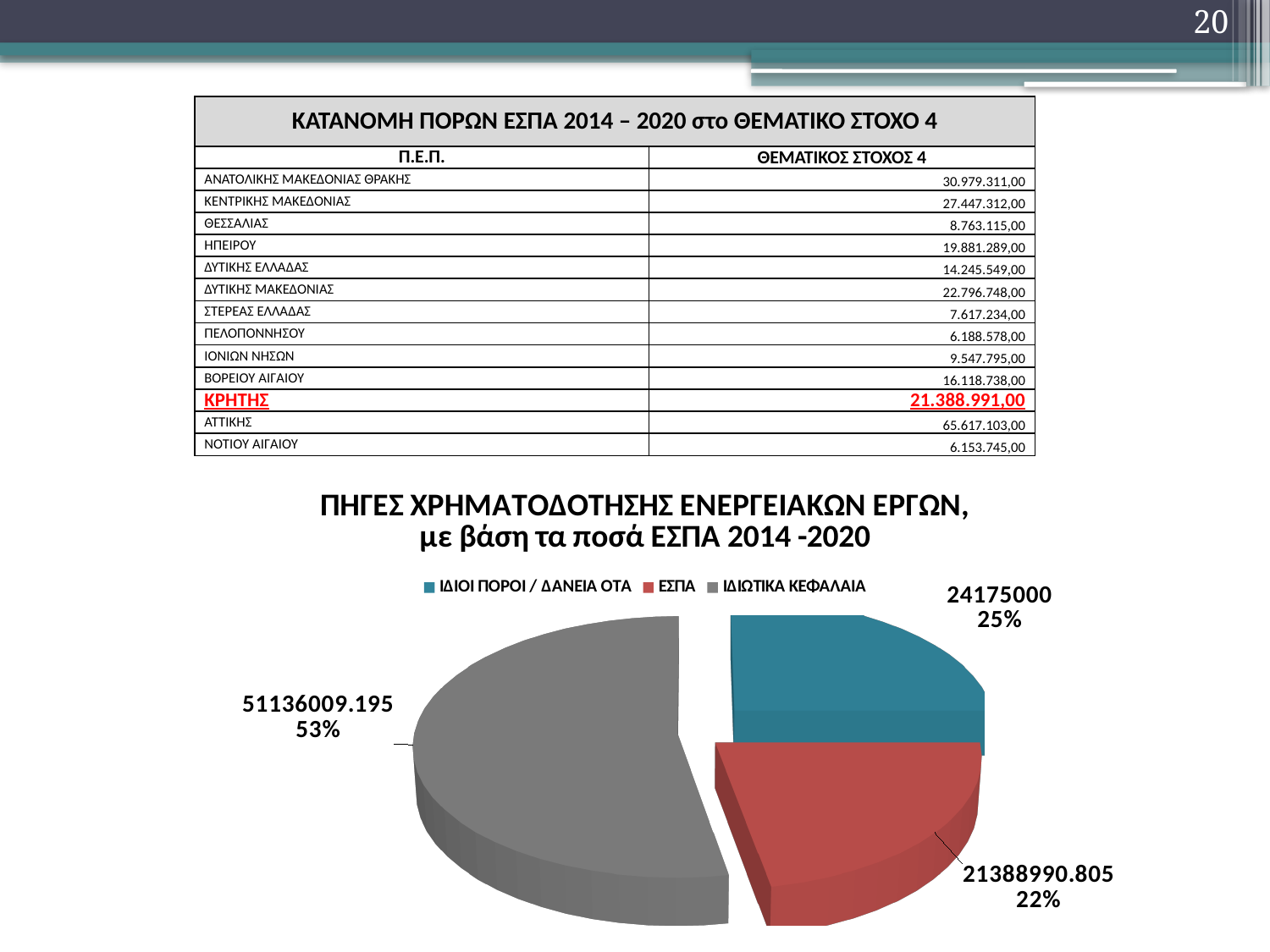
In the pie chart, what share does ΕΣΠΑ have? 22% In the pie chart, which is larger: ΙΔΙΟΙ ΠΟΡΟΙ / ΔΑΝΕΙΑ ΟΤΑ or ΕΣΠΑ? ΙΔΙΟΙ ΠΟΡΟΙ / ΔΑΝΕΙΑ ΟΤΑ What kind of chart is shown at the bottom of the slide? pie chart In the pie chart, what share does ΙΔΙΟΙ ΠΟΡΟΙ / ΔΑΝΕΙΑ ΟΤΑ have? 25% Which funding source has the smallest slice in the pie chart? ΕΣΠΑ In the pie chart, what is the value for ΙΔΙΟΙ ΠΟΡΟΙ / ΔΑΝΕΙΑ ΟΤΑ? 24175000 In the pie chart, what is the value for ΙΔΙΩΤΙΚΑ ΚΕΦΑΛΑΙΑ? 51136009.195 In the pie chart, what share does ΙΔΙΩΤΙΚΑ ΚΕΦΑΛΑΙΑ have? 53% Which funding source has the largest slice in the pie chart? ΙΔΙΩΤΙΚΑ ΚΕΦΑΛΑΙΑ In the pie chart, what colour is the ΕΣΠΑ slice? red In the pie chart, what is the value for ΕΣΠΑ? 21388990.805 How many slices does the pie chart have? 3